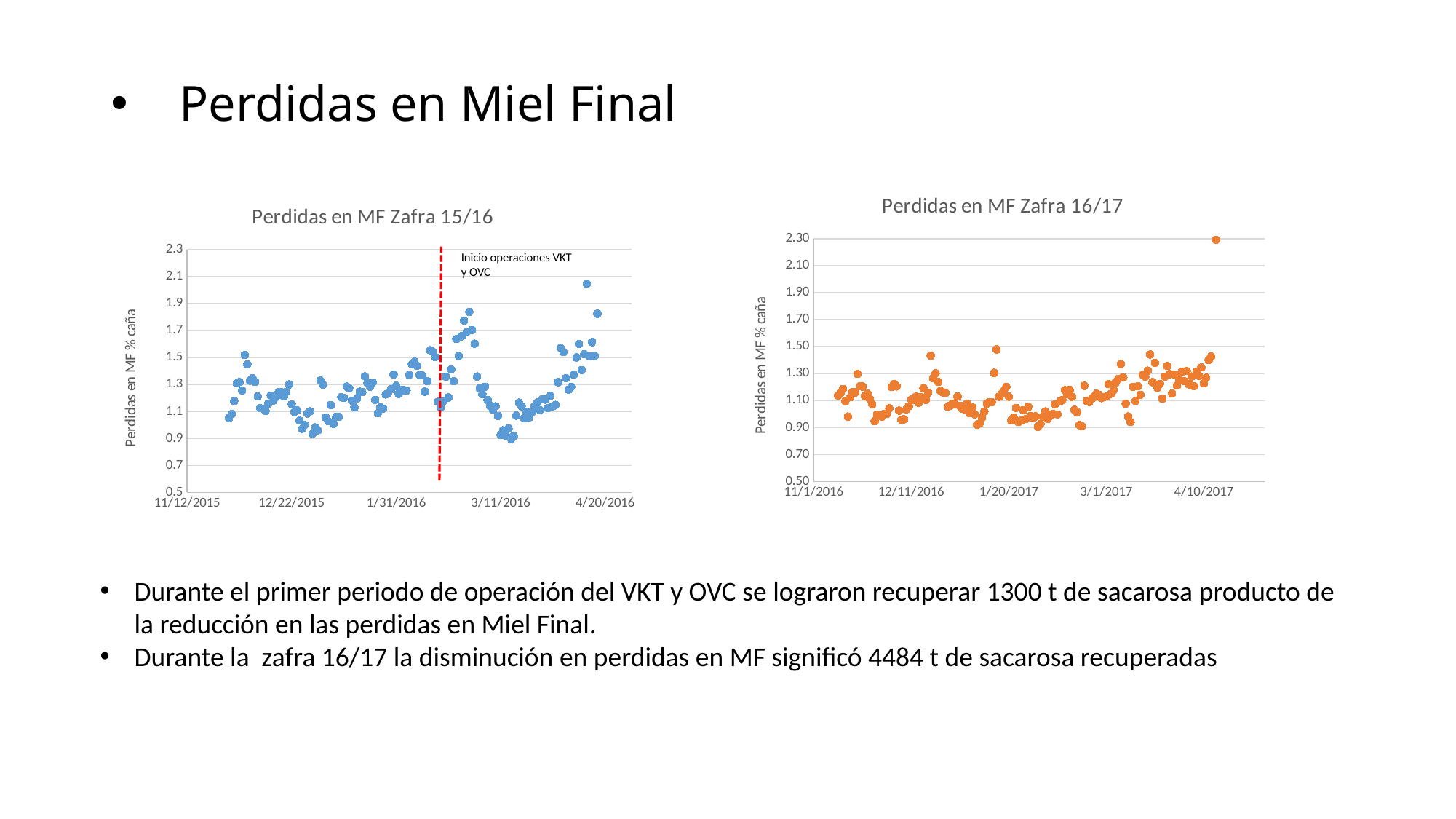
In the "Perdidas en MF Zafra 16/17" chart, is the lowest plotted point greater or less than 0.70? greater In the "Perdidas en MF Zafra 15/16" chart, is the lowest plotted point greater or less than 0.7? greater In the "Perdidas en MF Zafra 16/17" chart, is the highest plotted point greater or less than 1.90? greater What kind of chart is "Perdidas en MF Zafra 16/17"? Scatter chart In the "Perdidas en MF Zafra 15/16" chart, what is the label on the vertical axis? Perdidas en MF % caña What kind of chart is "Perdidas en MF Zafra 15/16"? Scatter chart In the "Perdidas en MF Zafra 15/16" chart, do the values generally rise or fall between 3/11/2016 and 4/20/2016? rise In the "Perdidas en MF Zafra 15/16" chart, what text is written next to the red dashed vertical line? Inicio operaciones VKT y OVC In the "Perdidas en MF Zafra 16/17" chart, do the values generally rise or fall between 3/1/2017 and 4/10/2017? rise